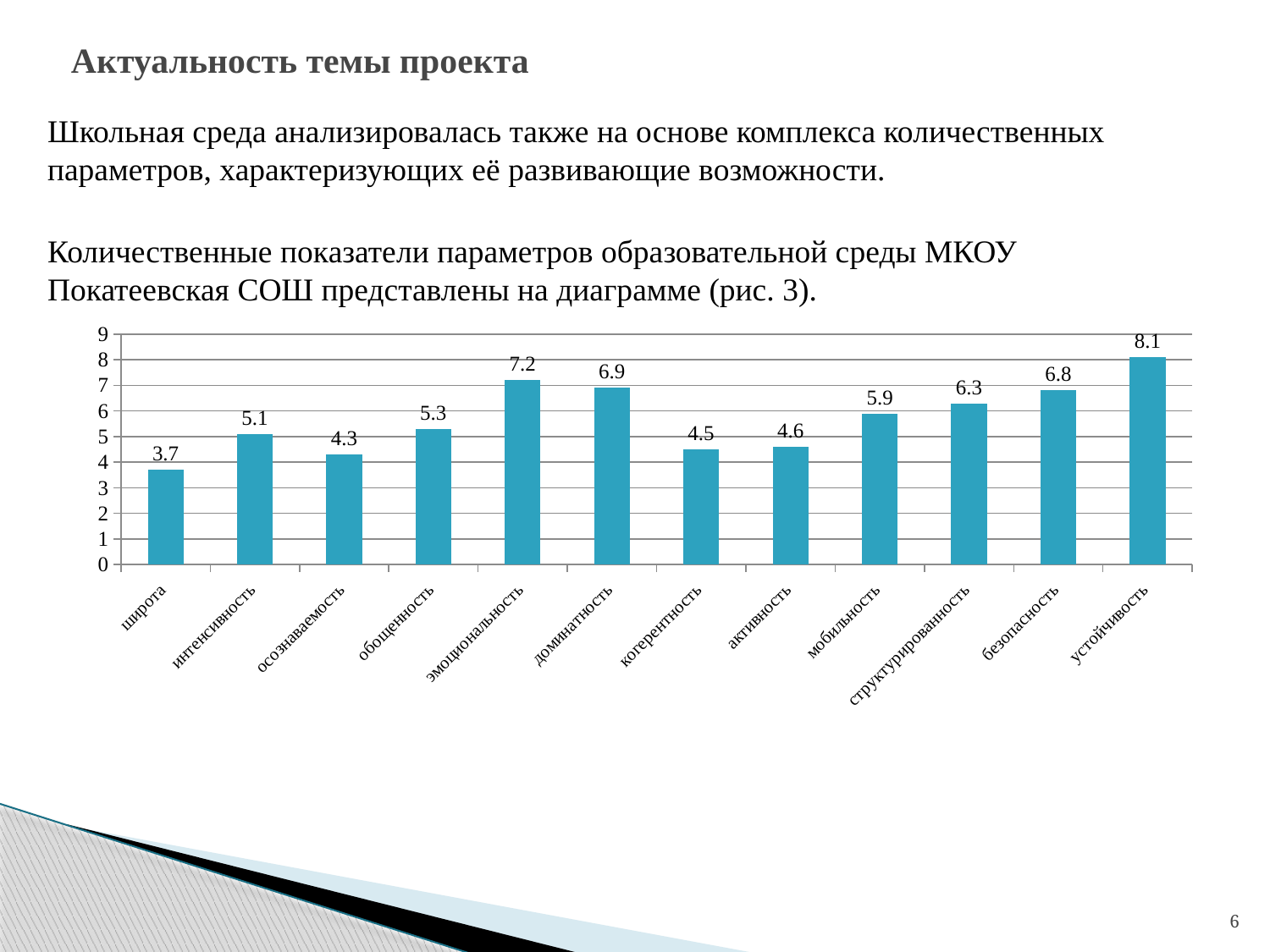
Which category has the lowest value? широта What is the value for широта? 3.7 What is the value for эмоциональность? 7.2 Is the value for мобильность greater or less than 5? greater Which is larger, the value for доминантность or the value for безопасность? доминантность Which category has the highest value? устойчивость What is the value for структурированность? 6.3 What is the difference between the values for устойчивость and широта? 4.4 What is the maximum value shown on the vertical axis? 9 What kind of chart is shown on the slide? bar chart How many categories are shown on the chart? 12 What is the difference between the values for эмоциональность and доминантность? 0.3